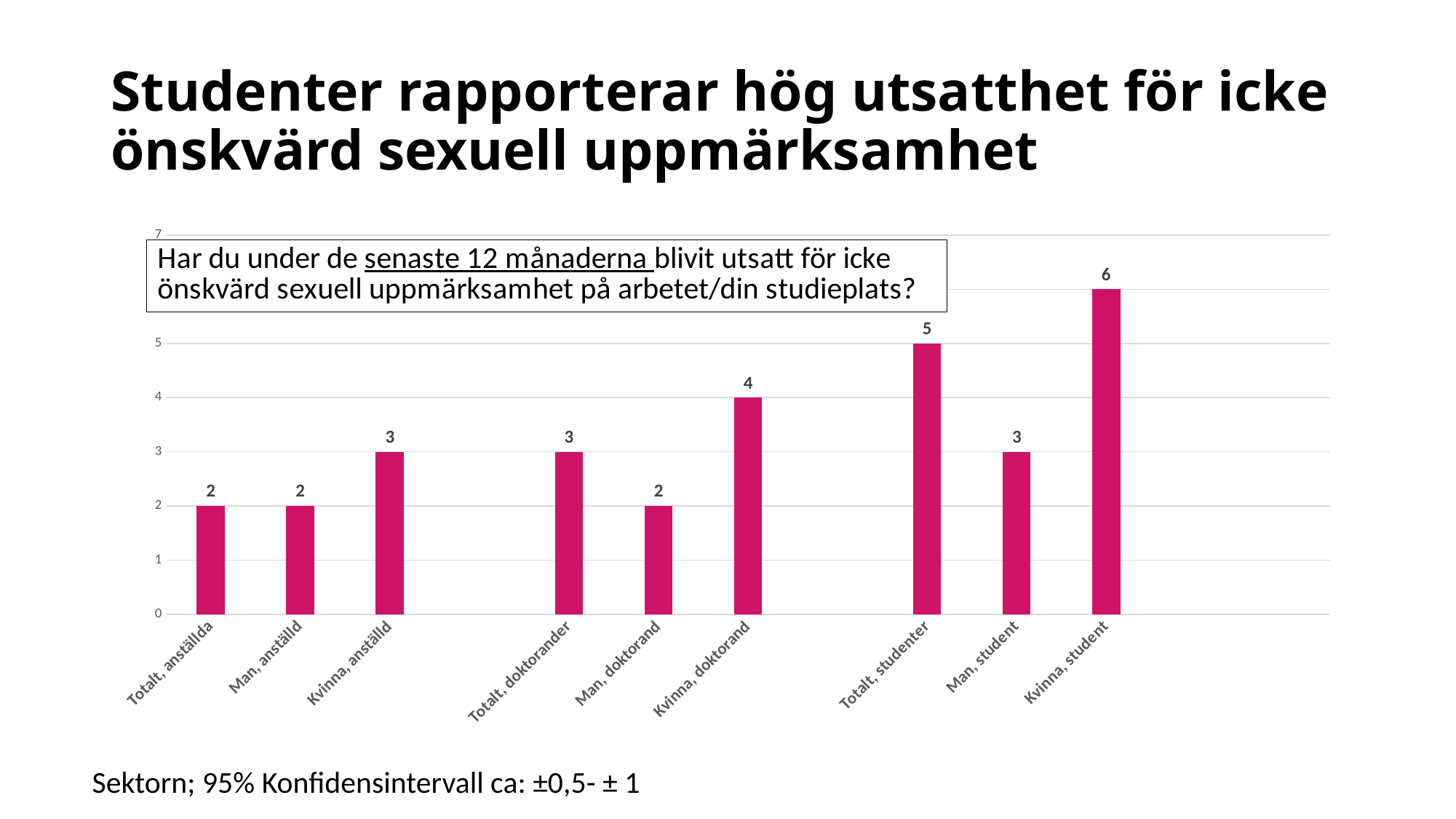
What is the value for Kvinna, doktorand? 4 What is the value for Totalt, doktorander? 3 What is the difference between Kvinna, doktorand and Man, doktorand? 2 What is the highest tick value shown on the y axis? 7 What is the value for Totalt, studenter? 5 What is the difference between Kvinna, student and Man, student? 3 What is the value for Man, anställd? 2 How many categories are shown on the x axis? 9 What is the value for Kvinna, student? 6 Which is larger, the value for Totalt, studenter or the value for Totalt, anställda? Totalt, studenter What kind of chart is shown on the slide? bar chart Which category has the highest value? Kvinna, student